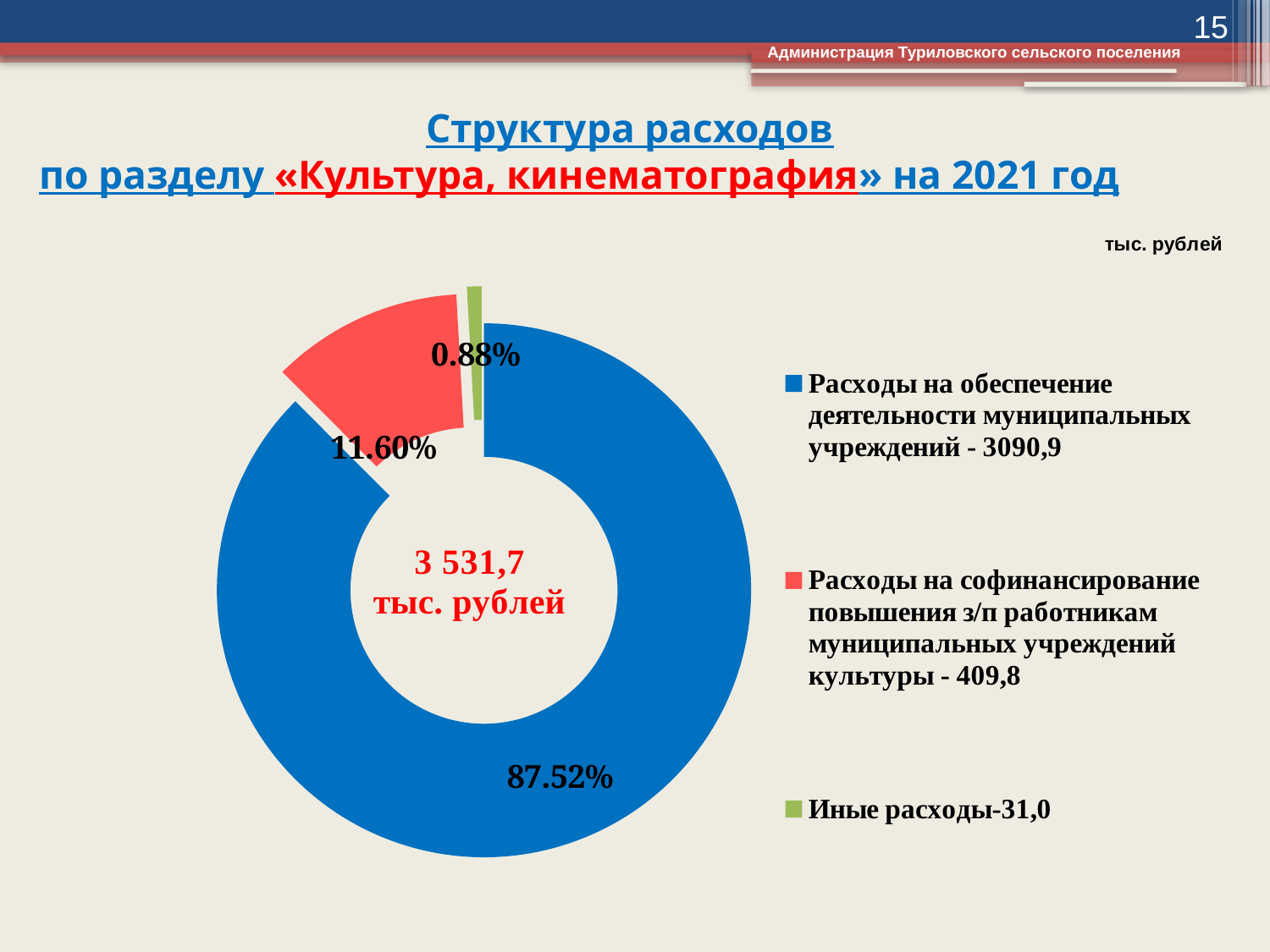
What total amount is shown in the centre of the doughnut? 3 531,7 тыс. рублей Which category has the largest share of the pie? Расходы на обеспечение деятельности муниципальных учреждений How many categories does the pie chart have? 3 What is the value for "Иные расходы" in thousand rubles? 31,0 What is the difference in percentage points between the 87.52% slice and the 11.60% slice? 75.92 Which category has the smallest share of the pie? Иные расходы What share of the pie does "Расходы на обеспечение деятельности муниципальных учреждений" take? 87.52% What is the value for "Расходы на обеспечение деятельности муниципальных учреждений" in thousand rubles? 3090,9 What share of the pie does "Расходы на софинансирование повышения з/п работникам муниципальных учреждений культуры" take? 11.60% Which colour represents "Иные расходы" in the legend? Green What kind of chart is shown on the slide? Pie chart (doughnut) What share of the pie does "Иные расходы" take? 0.88%